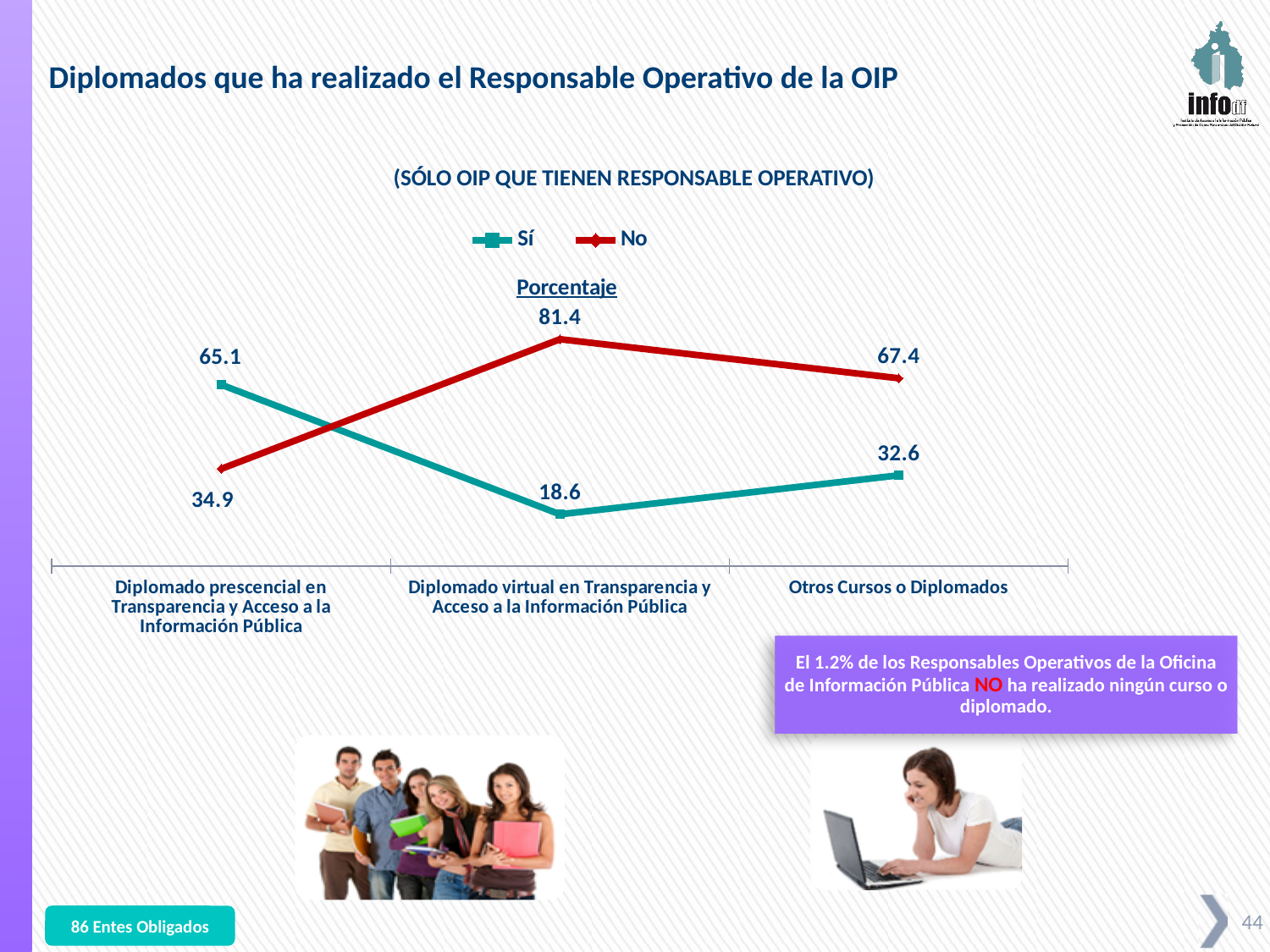
For which category is the "Sí" series highest? Diplomado prescencial en Transparencia y Acceso a la Información Pública What kind of chart is shown on the slide? Line chart What is the title shown above the plotted lines? Porcentaje What is the value of the "No" series for "Diplomado virtual en Transparencia y Acceso a la Información Pública"? 81.4 What is the value of the "Sí" series for "Diplomado prescencial en Transparencia y Acceso a la Información Pública"? 65.1 What is the value of the "No" series for "Diplomado prescencial en Transparencia y Acceso a la Información Pública"? 34.9 What is the value of the "Sí" series for "Otros Cursos o Diplomados"? 32.6 For "Otros Cursos o Diplomados", which series has the larger value, "Sí" or "No"? No How many categories are plotted along the x axis? 3 What is the difference between the "No" and "Sí" values for "Diplomado virtual en Transparencia y Acceso a la Información Pública"? 62.8 For which category is the "Sí" series lowest? Diplomado virtual en Transparencia y Acceso a la Información Pública How many series does the legend list? 2